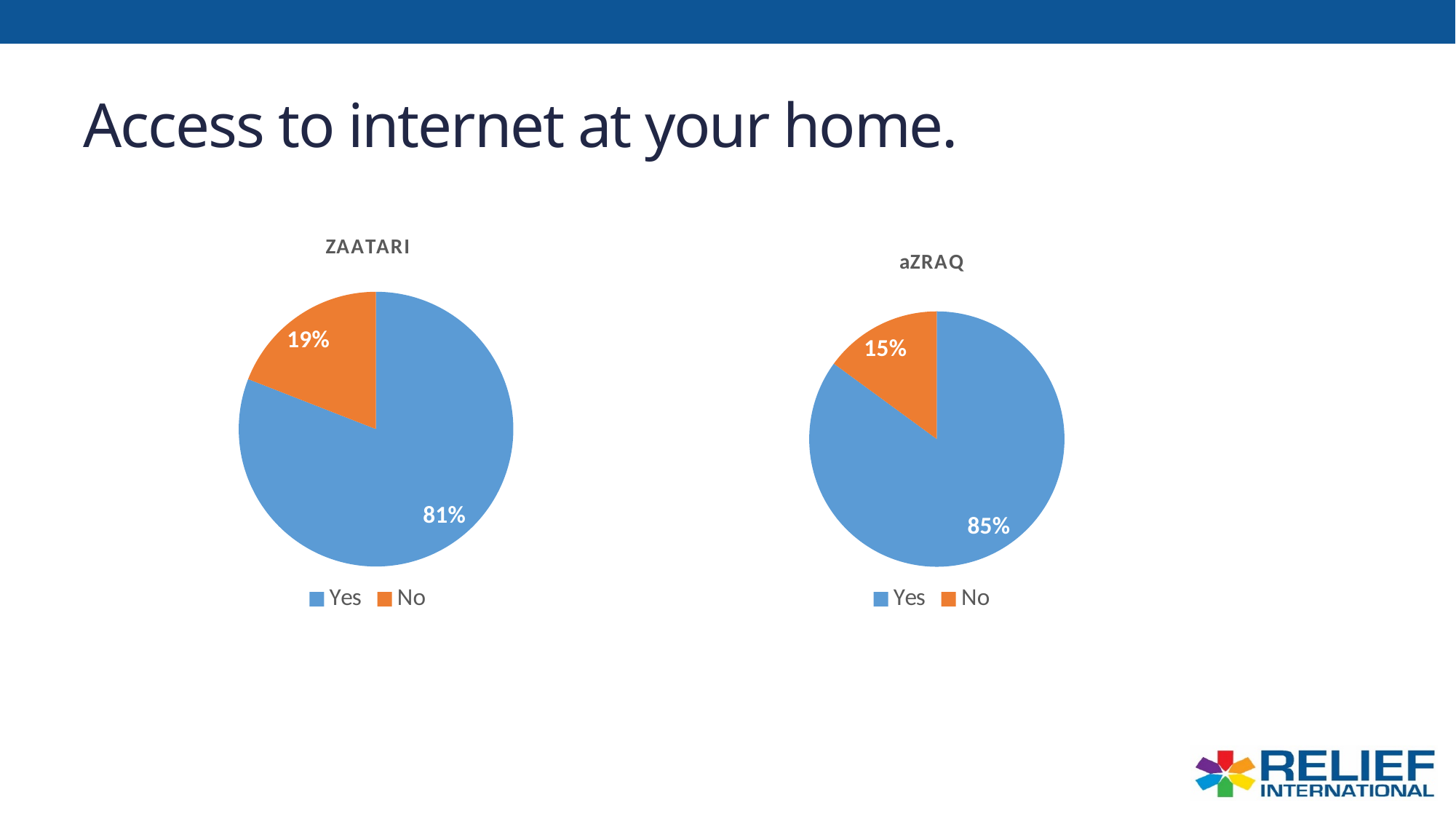
In the aZRAQ chart, which slice is the smallest? No In the aZRAQ chart, what percentage of respondents answered No? 15% In the aZRAQ chart, what percentage of respondents answered Yes? 85% In the ZAATARI chart, what percentage of respondents answered No? 19% In the ZAATARI chart, what is the difference between the Yes and No percentages? 62% In the aZRAQ chart, what colour represents the No slice? Orange How many entries does the legend of the ZAATARI chart list? 2 Comparing the two charts, which camp has the higher Yes percentage, ZAATARI or aZRAQ? aZRAQ In the ZAATARI chart, what percentage of respondents answered Yes? 81% What type of chart is the ZAATARI chart? Pie chart In the ZAATARI chart, which slice is the largest? Yes How many slices does the aZRAQ pie chart have? 2